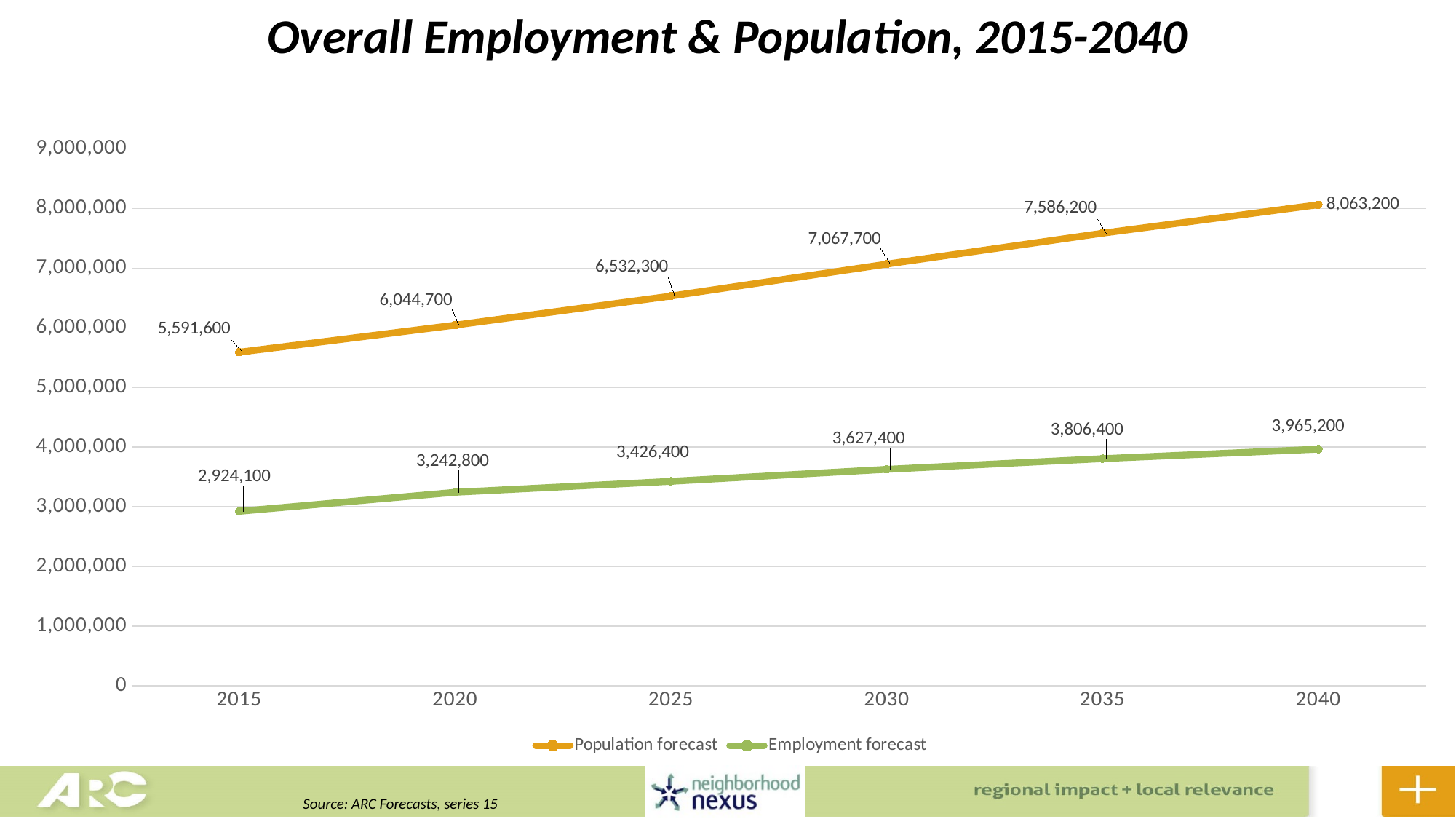
What is the Employment forecast value for 2025? 3,426,400 In which year is the Employment forecast lowest? 2015 What is the Employment forecast value for 2040? 3,965,200 How many series does the legend list? 2 By how much does the Employment forecast increase from 2015 to 2040? 1,041,100 What kind of chart is shown on the slide? Line chart How many years are plotted on the x axis? 6 What is the difference between the Population forecast and the Employment forecast in 2040? 4,098,000 What is the Population forecast value for 2030? 7,067,700 What is the Population forecast value for 2015? 5,591,600 In which year is the Population forecast highest? 2040 Which is larger in 2035, the Population forecast or the Employment forecast? Population forecast